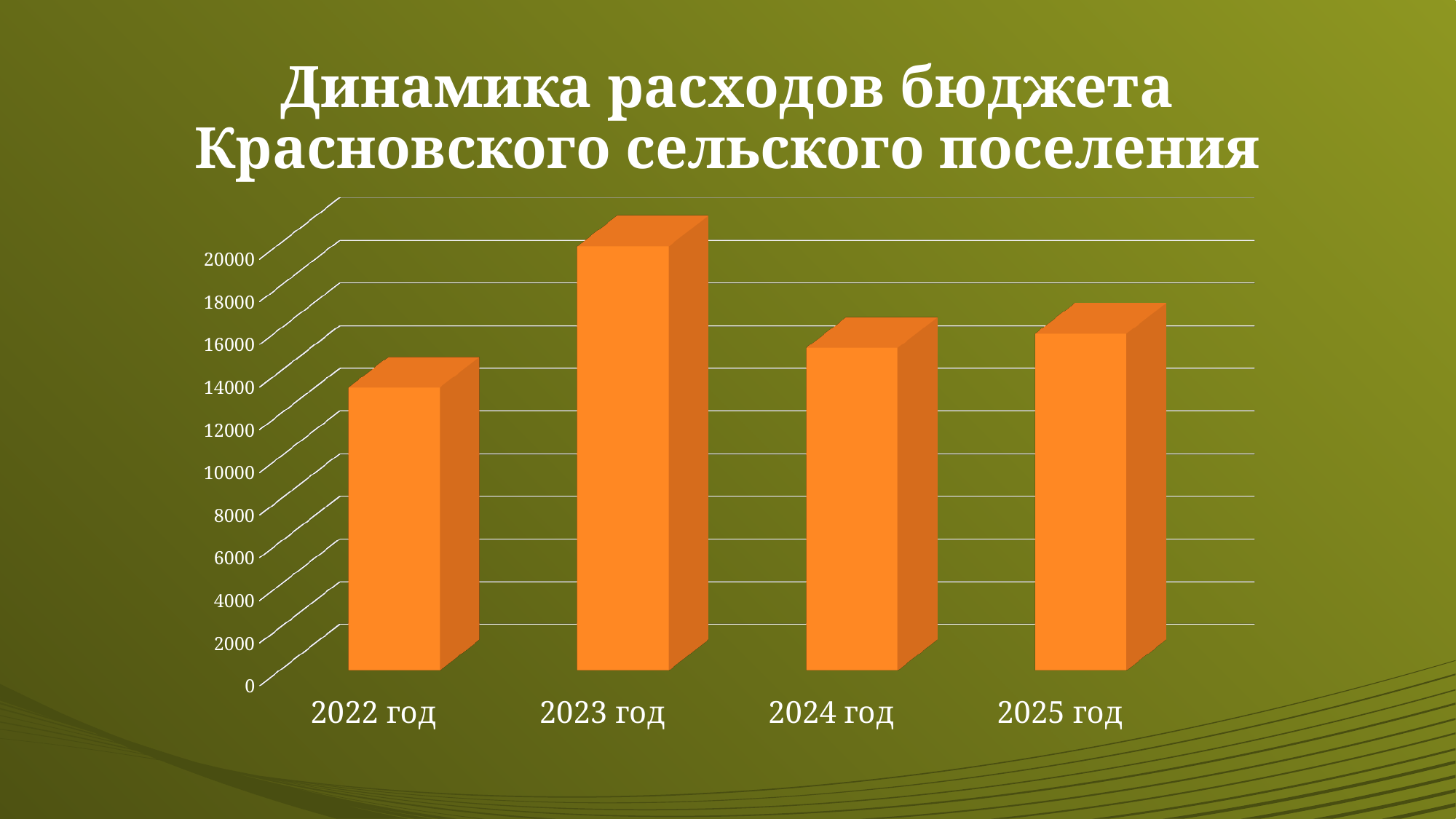
What kind of chart is shown on the slide? bar chart Is the value for 2024 год greater or less than 18000? less What is the title of the chart on the slide? Динамика расходов бюджета Красновского сельского поселения Which year has the lowest budget expenditure in the chart? 2022 год Is the value for 2025 год greater or less than 14000? greater Is the value for 2023 год greater or less than 18000? greater How many years (categories) are shown on the x axis of the chart? 4 Does the value rise or fall from 2023 год to 2024 год? fall Which is larger, the value for 2024 год or the value for 2022 год? 2024 год Which year has the highest budget expenditure in the chart? 2023 год